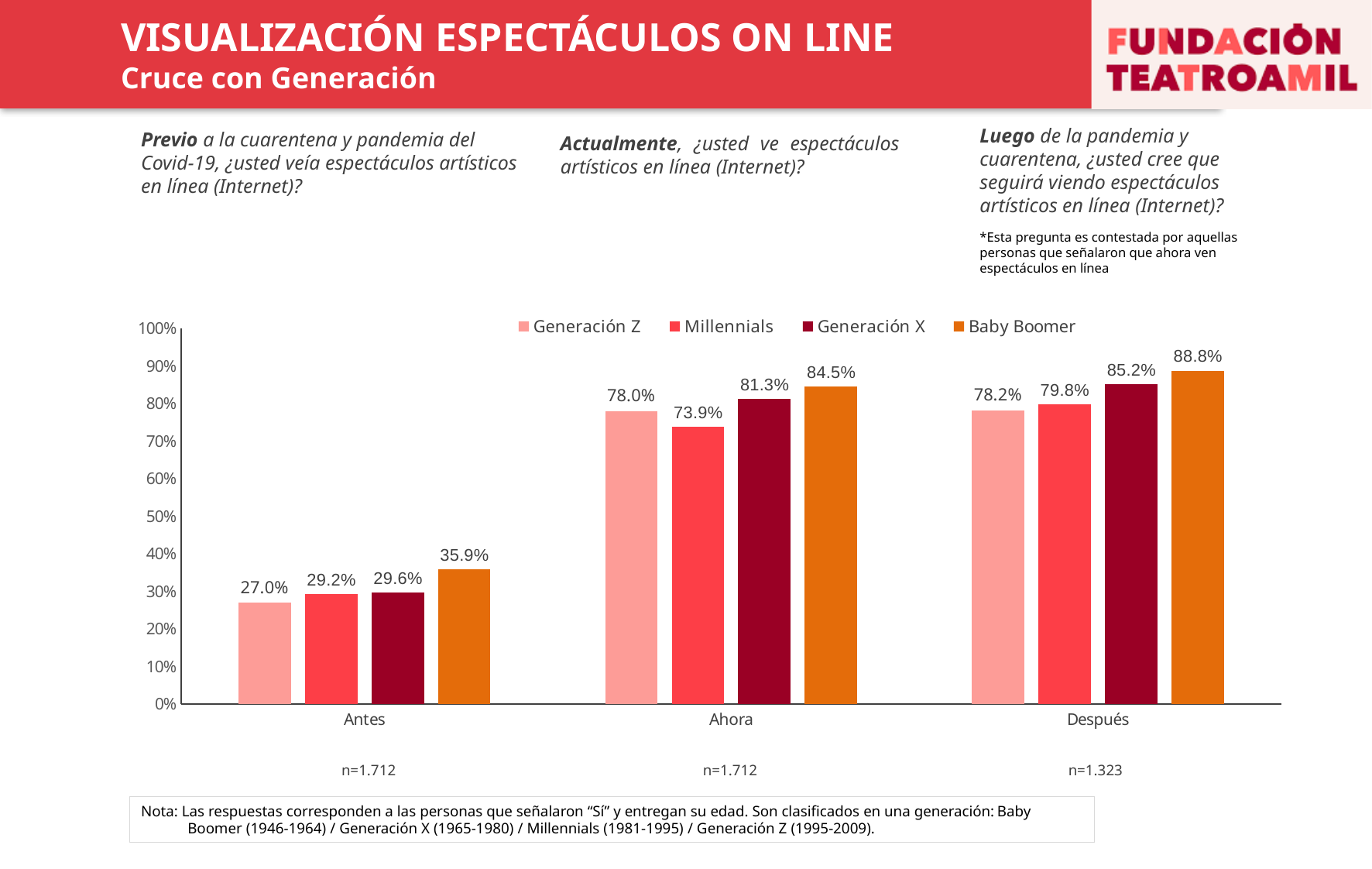
What is the value for Millennials in the Ahora category? 73.9% How many categories are shown on the x axis? 3 Which generation has the highest value in the Después category? Baby Boomer What colour are the Baby Boomer bars? Orange What is the value for Baby Boomer in the Antes category? 35.9% How many series does the legend list? 4 Do the Baby Boomer values rise or fall from Antes to Después? Rise What is the value for Generación X in the Después category? 85.2% What is the difference between the Baby Boomer value and the Generación Z value in the Ahora category? 6.5% Which generation has the lowest value in the Antes category? Generación Z Which is larger in the Ahora category: Generación Z or Millennials? Generación Z What kind of chart is shown on the slide? Bar chart